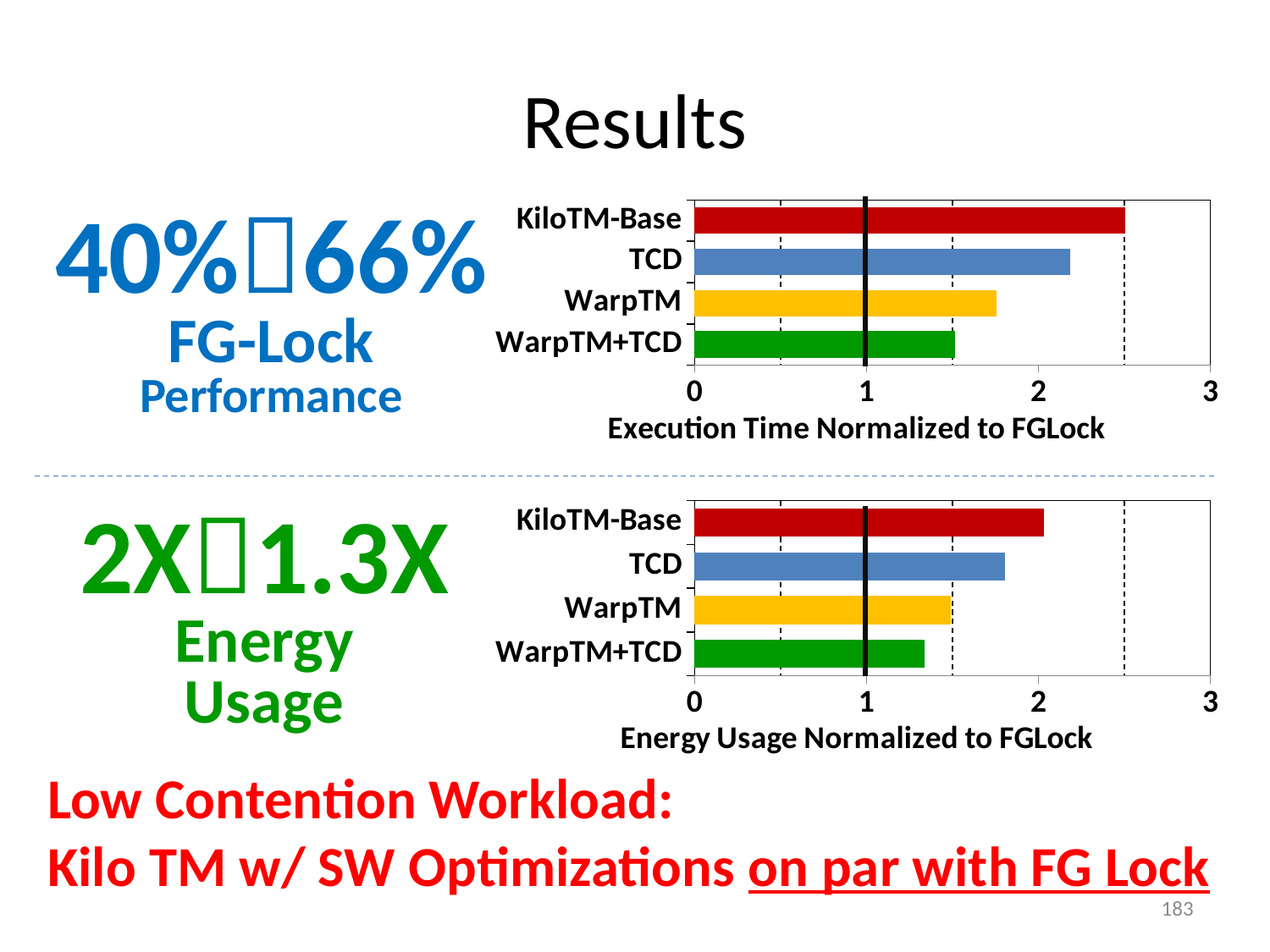
In the top chart (Execution Time Normalized to FGLock), is the value for KiloTM-Base greater or less than 2? greater In the top chart (Execution Time Normalized to FGLock), which is larger, the value for TCD or the value for WarpTM? TCD In the bottom chart (Energy Usage Normalized to FGLock), which category has the longest bar? KiloTM-Base In the top chart (Execution Time Normalized to FGLock), which category has the shortest bar? WarpTM+TCD In the bottom chart (Energy Usage Normalized to FGLock), is the value for TCD greater or less than 2? less What is the x-axis title of the bottom chart? Energy Usage Normalized to FGLock In the top chart (Execution Time Normalized to FGLock), is the value for WarpTM+TCD greater or less than 2? less What kind of chart is the top chart, titled 'Execution Time Normalized to FGLock'? bar chart How many categories are plotted in the top chart (Execution Time Normalized to FGLock)? 4 In the bottom chart (Energy Usage Normalized to FGLock), which category has the shortest bar? WarpTM+TCD In the top chart (Execution Time Normalized to FGLock), which category has the longest bar? KiloTM-Base